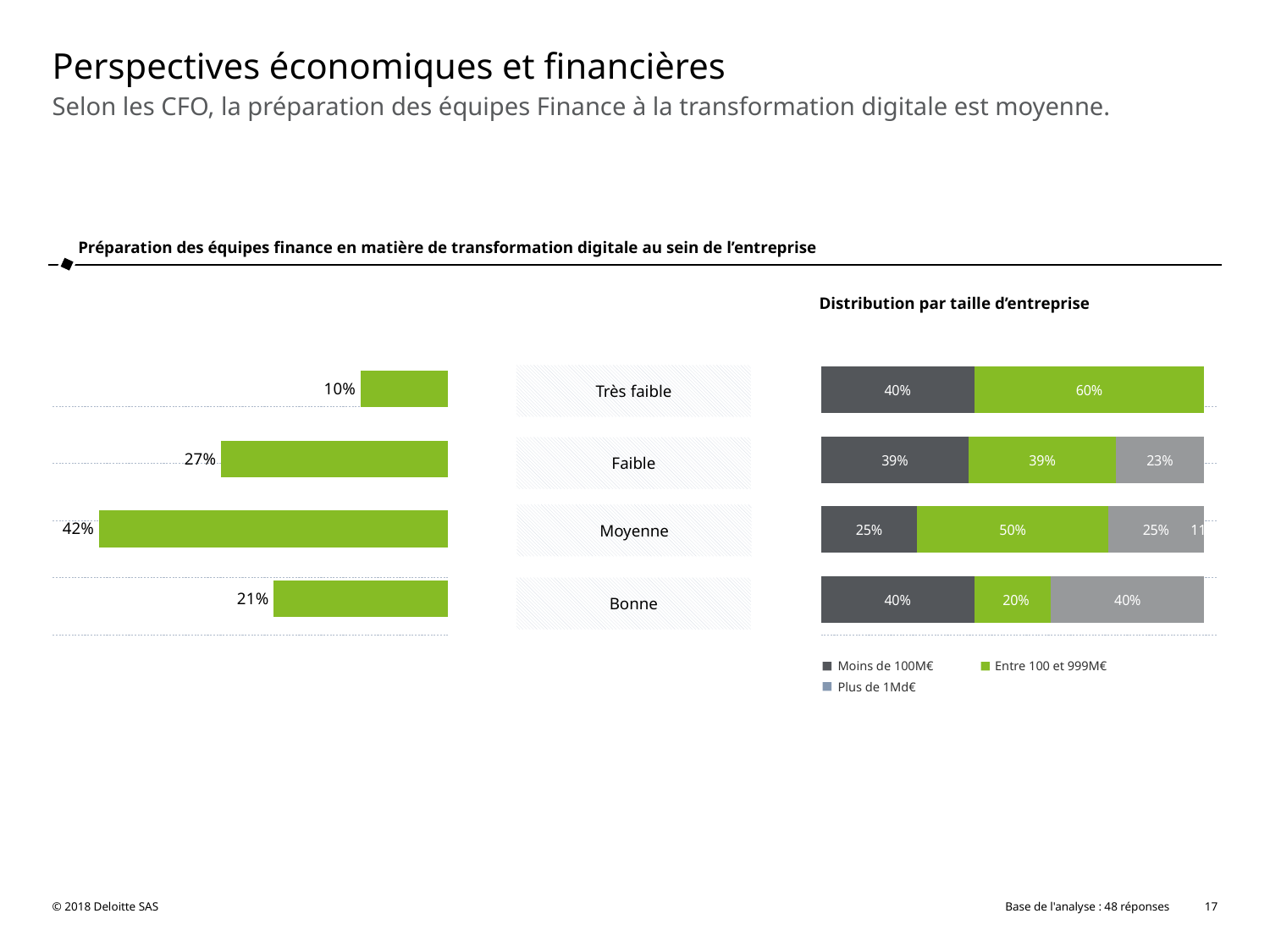
What type of chart is the 'Distribution par taille d'entreprise' chart? Stacked bar chart In the left bar chart, what is the difference between the values for 'Faible' and 'Bonne'? 6% In the left bar chart, which category has the lowest value? Très faible In the 'Distribution par taille d'entreprise' chart, what is the value for 'Moins de 100M€' in the 'Moyenne' row? 25% In the 'Distribution par taille d'entreprise' chart, what is the value for 'Entre 100 et 999M€' in the 'Très faible' row? 60% In the left bar chart, what percentage of CFOs rate the preparation of finance teams as 'Moyenne'? 42% In the left bar chart, which category has the highest value? Moyenne In the left bar chart, how many categories are shown? 4 In the 'Distribution par taille d'entreprise' chart, what is the value for 'Plus de 1Md€' in the 'Faible' row? 23% In the 'Distribution par taille d'entreprise' chart, which is larger in the 'Bonne' row: 'Moins de 100M€' or 'Entre 100 et 999M€'? Moins de 100M€ In the 'Distribution par taille d'entreprise' chart, how many series does the legend list? 3 In the left bar chart, what is the value for 'Très faible'? 10%